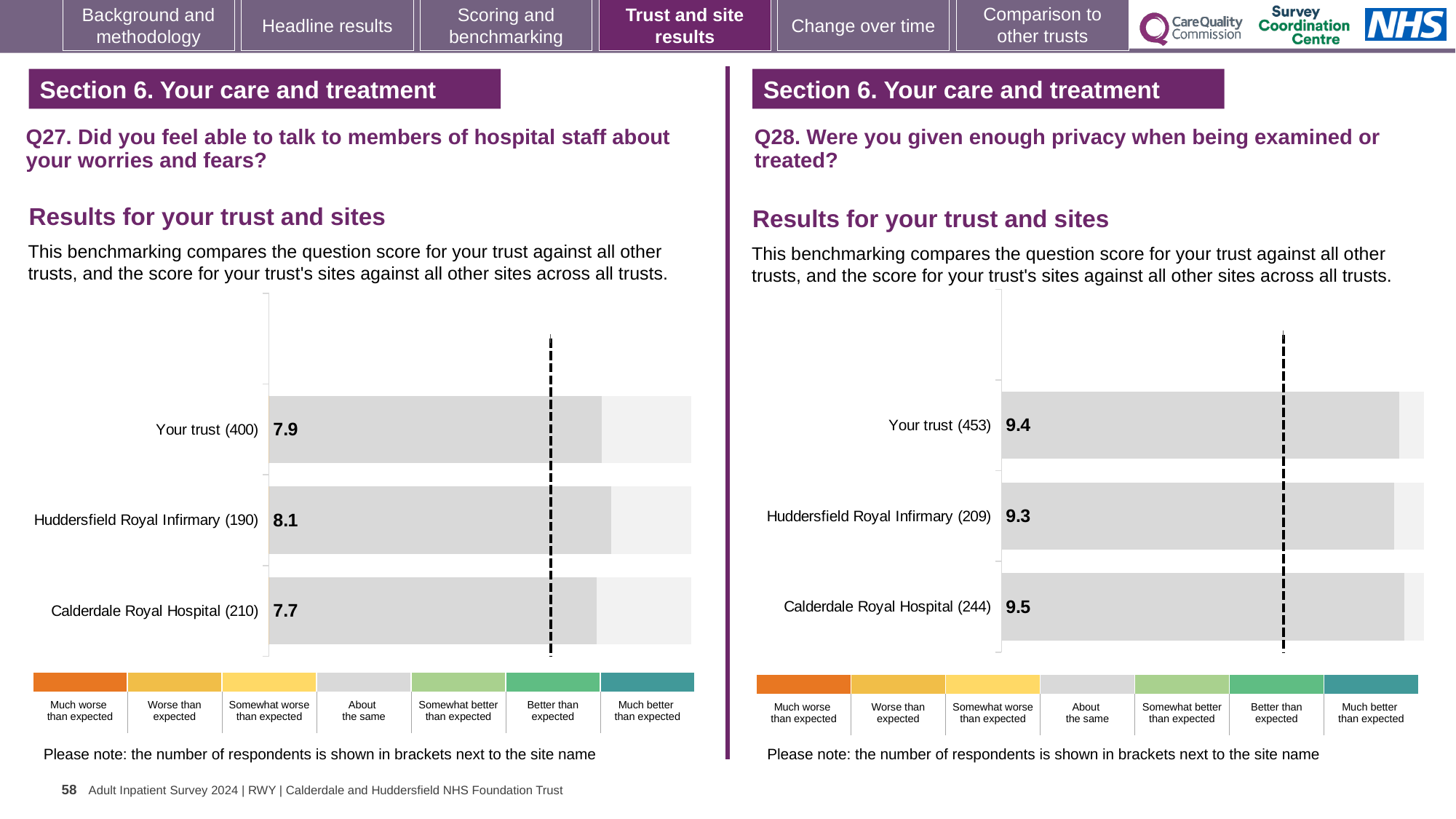
In the Q28 chart on the right, how many bars are plotted? 3 In the Q28 chart on the right, which site or trust has the highest score? Calderdale Royal Hospital In the Q28 chart on the right, which is larger: the score for Your trust or for Huddersfield Royal Infirmary? Your trust What kind of chart is used in the Q27 chart on the left? Bar chart In the Q27 chart on the left, what is the score for Your trust? 7.9 In the Q27 chart on the left, which site or trust has the highest score? Huddersfield Royal Infirmary In the Q28 chart on the right, what is the score for Your trust? 9.4 In the Q27 chart on the left, what is the score for Huddersfield Royal Infirmary? 8.1 In the Q28 chart on the right, what is the score for Calderdale Royal Hospital? 9.5 In the Q27 chart on the left, which site or trust has the lowest score? Calderdale Royal Hospital In the Q27 chart on the left, what is the difference between the scores for Huddersfield Royal Infirmary and Calderdale Royal Hospital? 0.4 In the Q28 chart on the right, how many respondents are shown in brackets for Huddersfield Royal Infirmary? 209